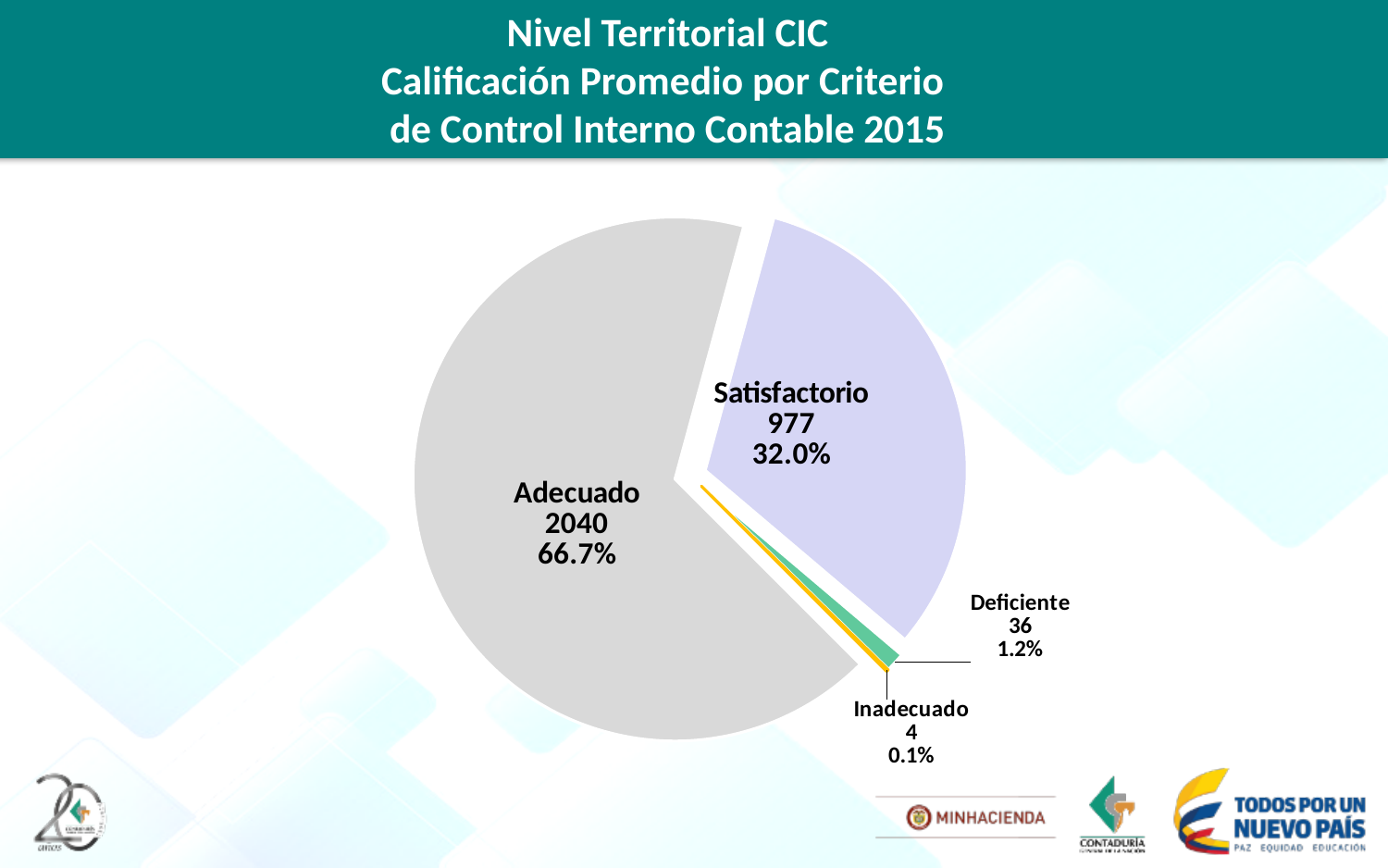
What share of the pie does Satisfactorio represent? 32.0% What is the value for Adecuado? 2040 Which category has the largest slice? Adecuado How many slices does the pie chart have? 4 What is the difference between the values for Adecuado and Satisfactorio? 1063 What share of the pie does Deficiente represent? 1.2% Which category has the smallest slice? Inadecuado What is the value for Inadecuado? 4 What kind of chart is shown on the slide? Pie chart What is the value for Deficiente? 36 What is the value for Satisfactorio? 977 Which is larger, the value for Deficiente or the value for Inadecuado? Deficiente